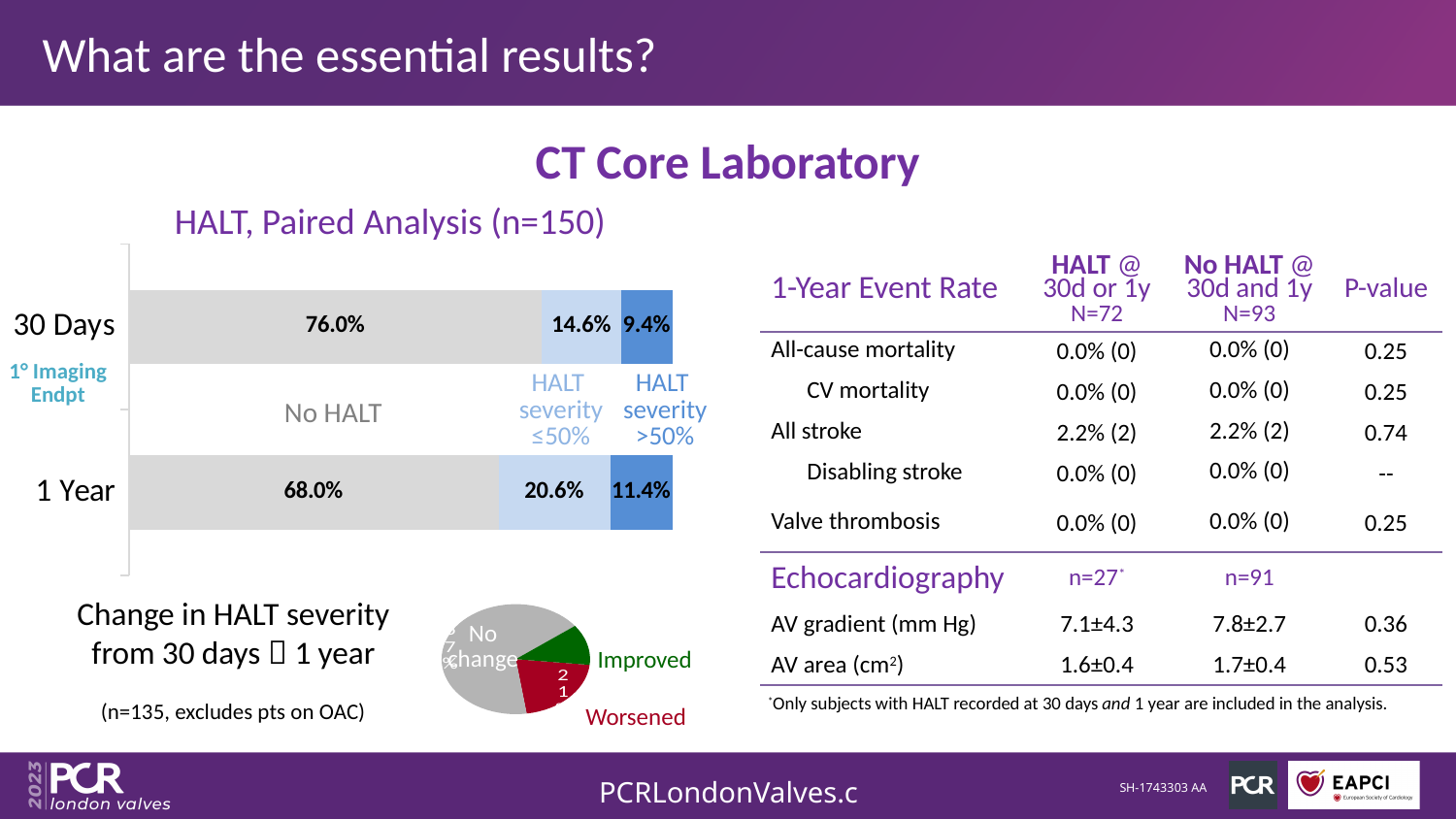
In the HALT, Paired Analysis bar chart, what is the difference between the HALT severity ≤50% values at 1 Year and 30 Days? 6.0% In the Change in HALT severity pie chart, how many slices are there? 3 In the HALT, Paired Analysis bar chart, which time point has the higher HALT severity ≤50% value, 30 Days or 1 Year? 1 Year In the HALT, Paired Analysis bar chart, what is the difference between the No HALT values at 30 Days and 1 Year? 8.0% In the HALT, Paired Analysis bar chart, how many segments (series) make up each bar? 3 In the HALT, Paired Analysis bar chart, how many time points (categories) are shown? 2 In the HALT, Paired Analysis bar chart, what is the HALT severity ≤50% value at 30 Days? 14.6% In the HALT, Paired Analysis bar chart, what is the HALT severity >50% value at 1 Year? 11.4% In the HALT, Paired Analysis bar chart, what is the No HALT value at 1 Year? 68.0% In the HALT, Paired Analysis bar chart, what is the No HALT value at 30 Days? 76.0% What type of chart is the HALT, Paired Analysis chart? Stacked bar chart In the Change in HALT severity pie chart, which slice is the largest? No change